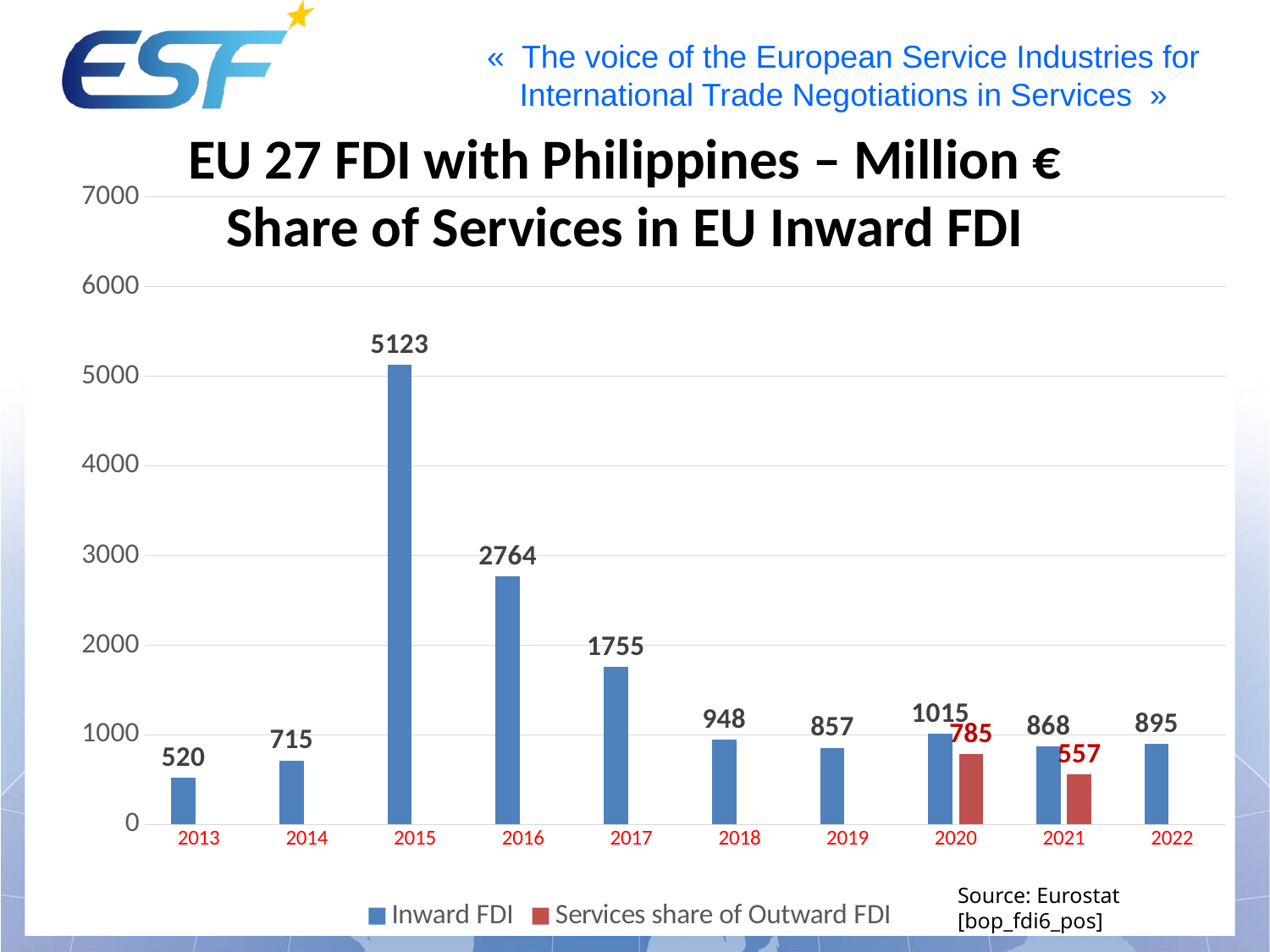
Which year has the highest Inward FDI value? 2015 How many series does the legend list? 2 How many years are shown on the x axis? 10 What is the Inward FDI value for 2013? 520 What is the difference between the Inward FDI values for 2015 and 2016? 2359 What is the Services share of Outward FDI value for 2021? 557 What kind of chart is shown on the slide? Bar chart What is the Services share of Outward FDI value for 2020? 785 What is the source cited for the chart? Eurostat [bop_fdi6_pos] Which year has the lowest Inward FDI value? 2013 Which is larger, the Inward FDI value for 2018 or for 2019? 2018 What is the Inward FDI value for 2015? 5123